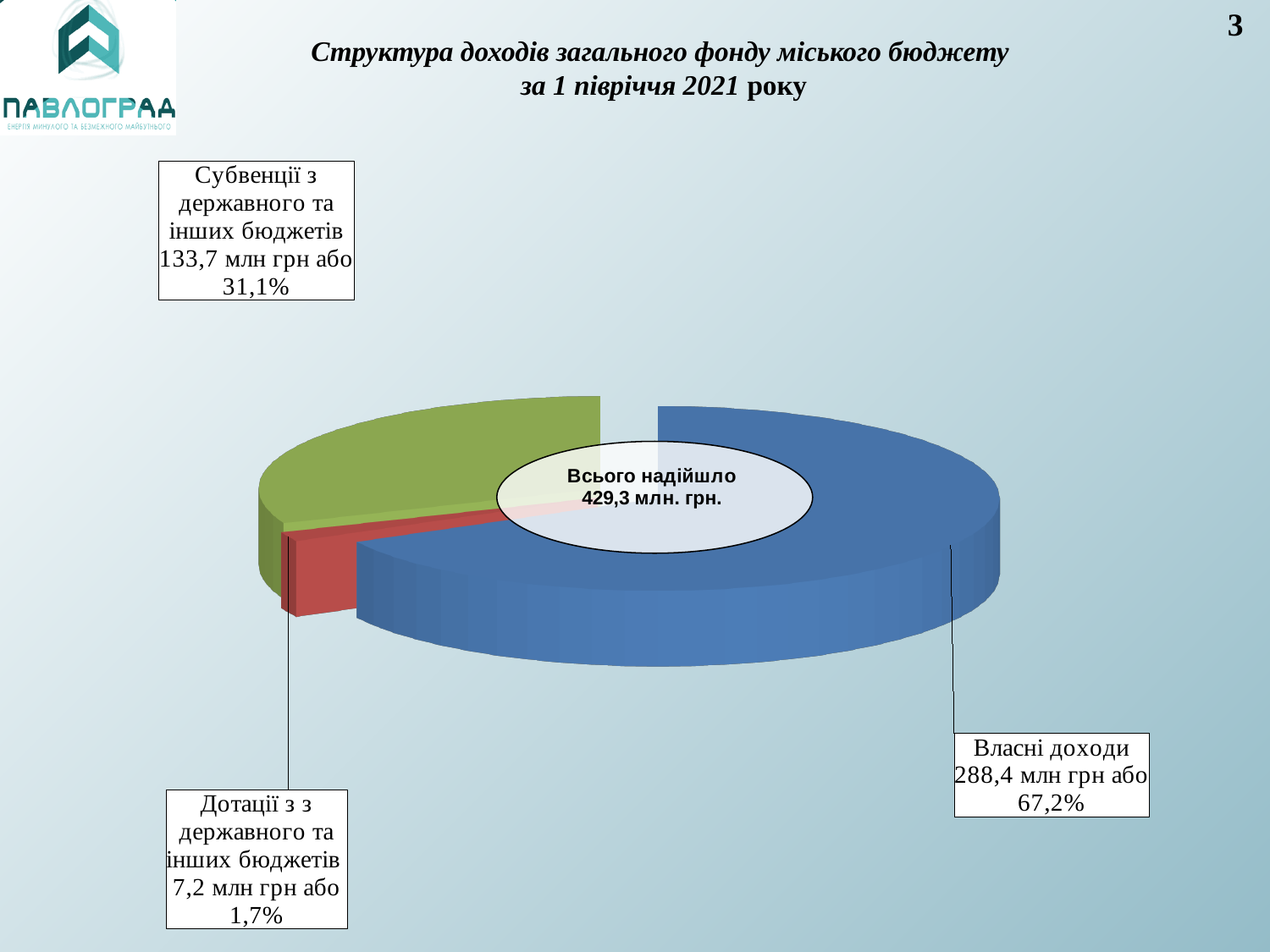
What total amount is shown in the centre of the pie chart? 429,3 млн. грн. What share of the pie does Власні доходи represent? 67,2% How many slices does the pie chart have? 3 Which category has the smallest slice of the pie? Дотації з державного та інших бюджетів What is the difference in млн грн between Власні доходи and Субвенції з державного та інших бюджетів? 154,7 млн грн What colour is the slice for Власні доходи? Blue What share of the pie does Субвенції з державного та інших бюджетів represent? 31,1% What is the value for Власні доходи? 288,4 млн грн What kind of chart is shown on the slide? Pie chart Which category has the largest slice of the pie? Власні доходи What is the value for Дотації з державного та інших бюджетів? 7,2 млн грн Which is larger, Субвенції з державного та інших бюджетів or Дотації з державного та інших бюджетів? Субвенції з державного та інших бюджетів